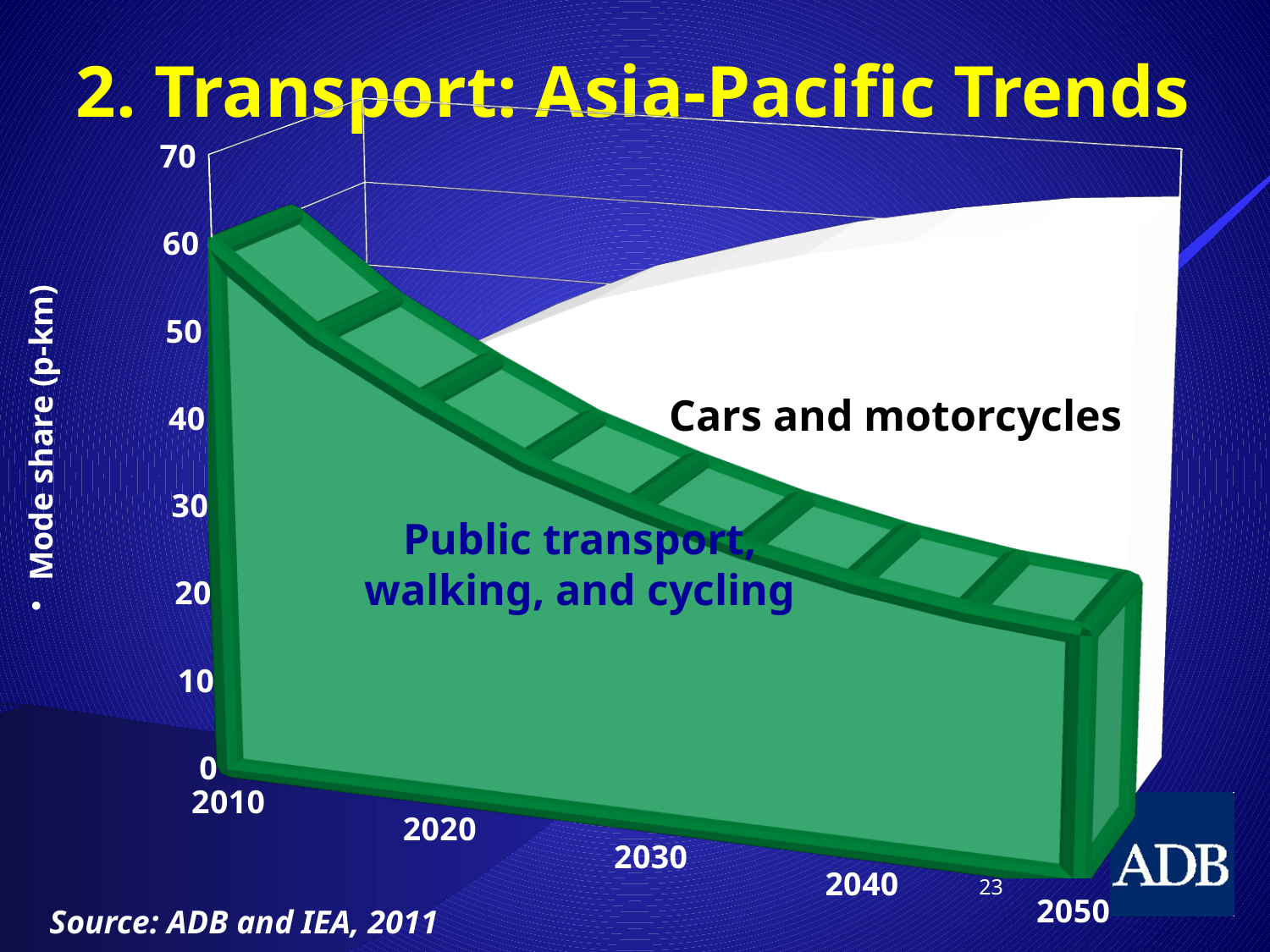
In which year is the mode share of public transport, walking, and cycling highest? 2010 Does the mode share of public transport, walking, and cycling rise or fall from 2010 to 2050? Fall What kind of chart is shown on the slide? Area chart How many years are labelled on the x axis of the chart? 5 What source is cited for the chart? ADB and IEA, 2011 Which series has the larger mode share in 2010, public transport, walking, and cycling or cars and motorcycles? Public transport, walking, and cycling What is the label of the y axis of the chart? Mode share (p-km) Which series has the larger mode share in 2050, public transport, walking, and cycling or cars and motorcycles? Cars and motorcycles How many series are plotted in the chart? 2 Is the mode share of public transport, walking, and cycling in 2050 greater or less than 40? less Does the mode share of cars and motorcycles rise or fall from 2010 to 2050? Rise Is the mode share of public transport, walking, and cycling in 2010 greater or less than 50? greater